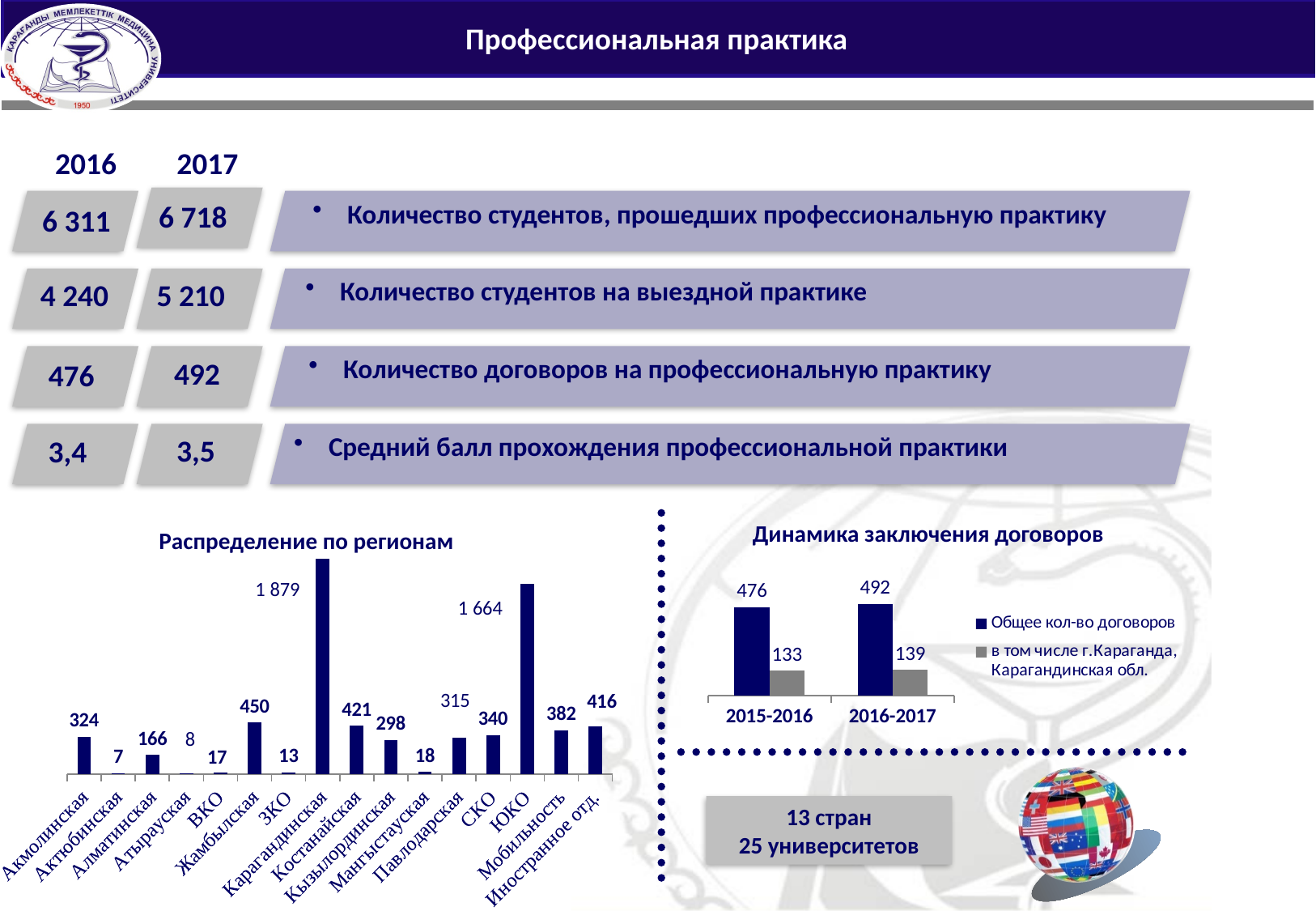
In the chart 'Распределение по регионам', what is the value for Карагандинская? 1 879 In the chart 'Распределение по регионам', which category has the highest value? Карагандинская In the chart 'Динамика заключения договоров', what is the value of 'Общее кол-во договоров' for 2016-2017? 492 In the chart 'Динамика заключения договоров', what is the difference between 'Общее кол-во договоров' for 2016-2017 and for 2015-2016? 16 In the chart 'Распределение по регионам', which is larger: the value for Костанайская or the value for Иностранное отд.? Костанайская In the chart 'Распределение по регионам', what is the difference between the values for Карагандинская and ЮКО? 215 What kind of chart is 'Распределение по регионам'? bar chart In the chart 'Распределение по регионам', what is the value for Жамбылская? 450 In the chart 'Распределение по регионам', which category has the lowest value? Актюбинская How many series does the legend of the chart 'Динамика заключения договоров' list? 2 How many categories are shown in the chart 'Распределение по регионам'? 16 In the chart 'Динамика заключения договоров', what is the value of 'в том числе г.Караганда, Карагандинская обл.' for 2015-2016? 133